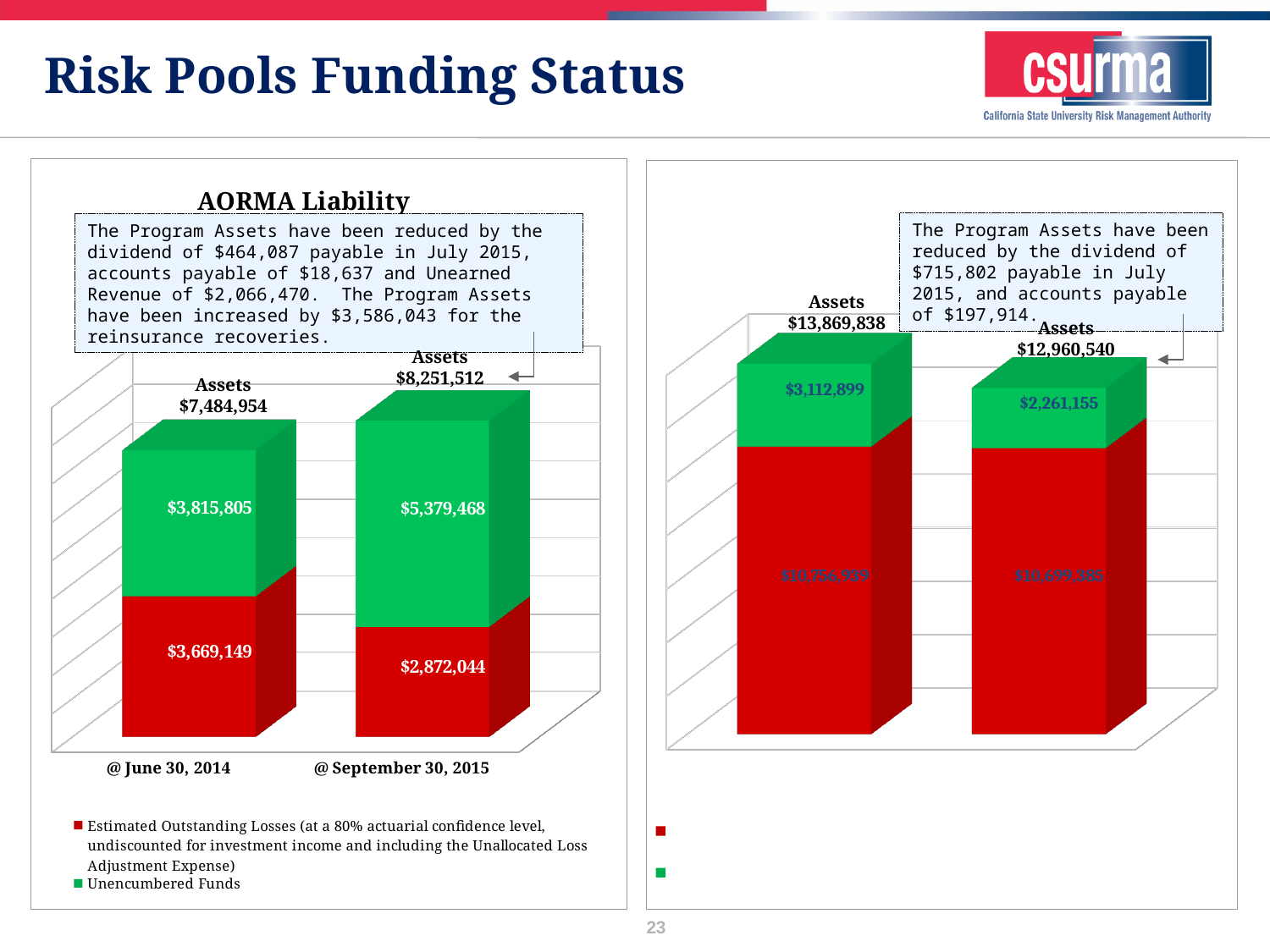
On the chart on the right side of the slide, what are the Assets shown for the left bar? $13,869,838 On the AORMA Liability chart, which colour represents Unencumbered Funds? Green On the AORMA Liability chart, what is the value of Unencumbered Funds at June 30, 2014? $3,815,805 On the AORMA Liability chart, how many series does the legend list? 2 On the AORMA Liability chart, what are the total Assets shown for June 30, 2014? $7,484,954 On the AORMA Liability chart, how many dates (categories) are plotted? 2 On the chart on the right side of the slide, what is the green segment value of the right bar? $2,261,155 What kind of chart is the AORMA Liability chart? Stacked bar chart On the AORMA Liability chart, what are the total Assets shown for September 30, 2015? $8,251,512 On the AORMA Liability chart, what is the value of Estimated Outstanding Losses at September 30, 2015? $2,872,044 On the AORMA Liability chart, which date has the larger Unencumbered Funds value? @ September 30, 2015 On the AORMA Liability chart, by how much did Estimated Outstanding Losses decrease from June 30, 2014 to September 30, 2015? $797,105